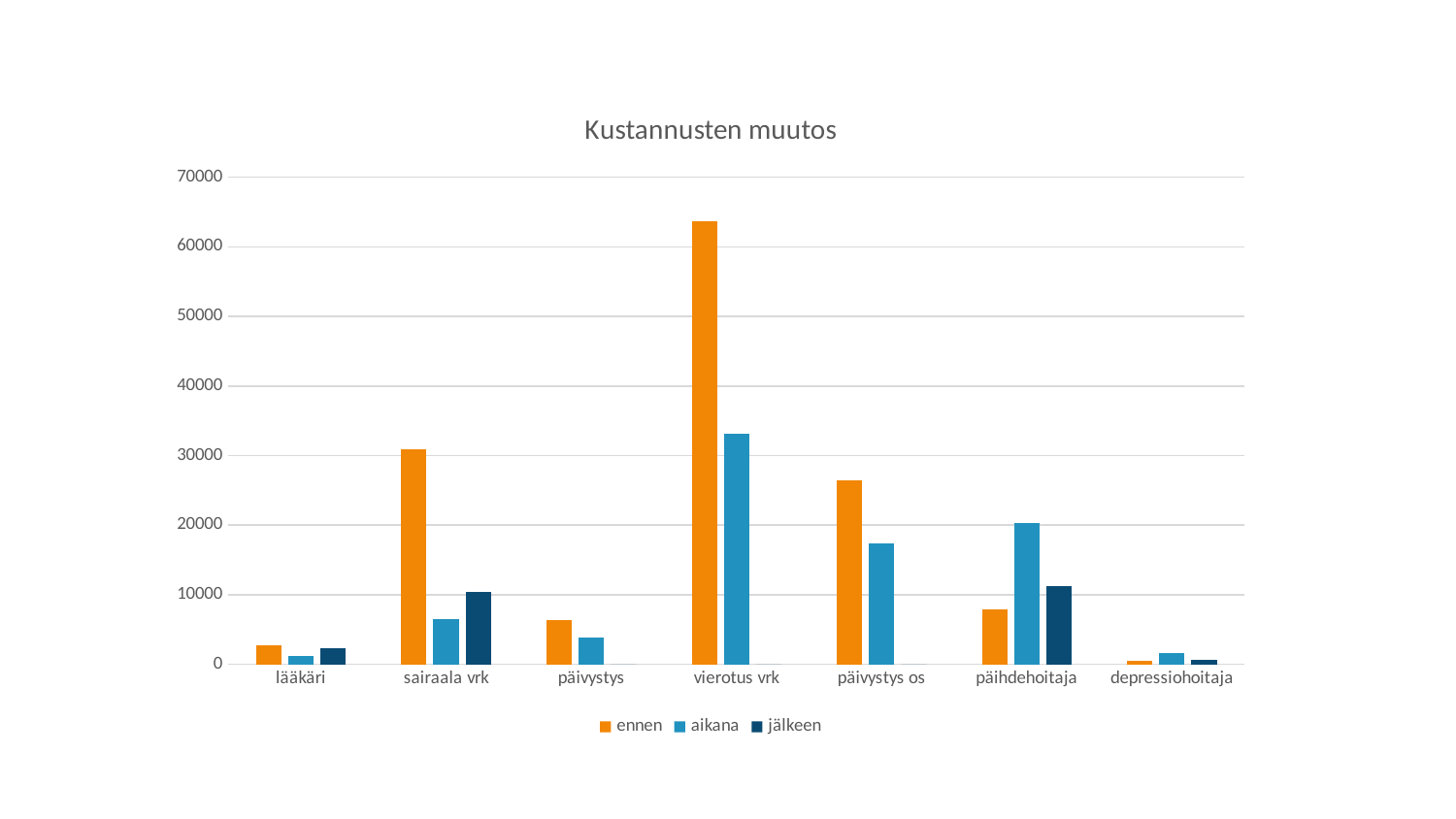
Which category has the lowest value for the 'ennen' series? depressiohoitaja How many categories are shown on the x axis? 7 How many series does the legend list? 3 Which category has the highest value for the 'ennen' series? vierotus vrk Is the 'ennen' value for vierotus vrk greater or less than 60000? greater For sairaala vrk, which series has the larger value, 'ennen' or 'aikana'? ennen Is the 'aikana' value for vierotus vrk greater or less than 30000? greater Is the 'aikana' value for päivystys os greater or less than 20000? less Which category has the highest value for the 'aikana' series? vierotus vrk What is the title of the chart? Kustannusten muutos What kind of chart is shown on the slide? bar chart For päihdehoitaja, which series has the larger value, 'ennen' or 'aikana'? aikana